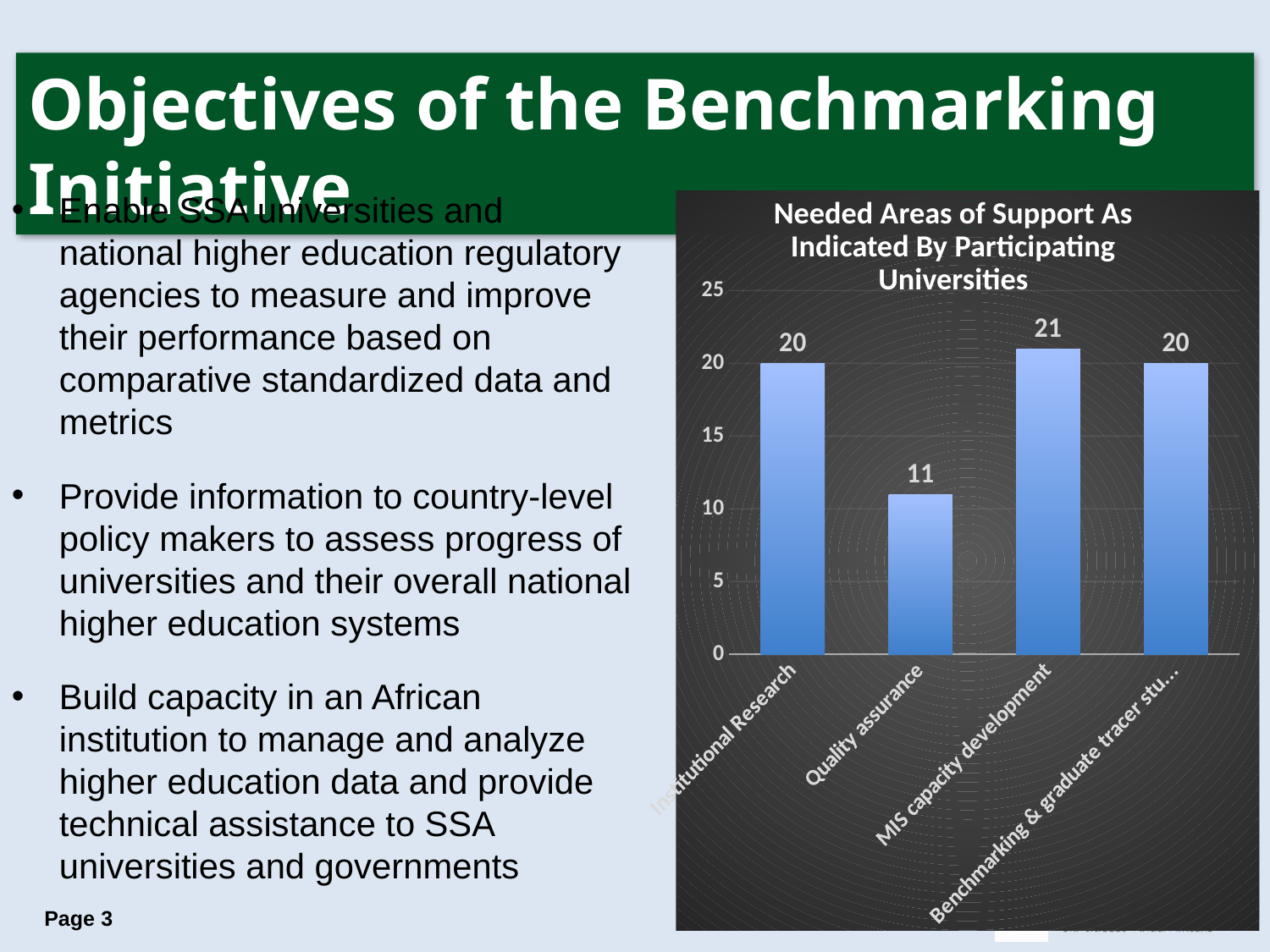
What value is shown for Institutional Research? 20 What kind of chart is shown on the slide? bar chart What is the difference between the values for MIS capacity development and Quality assurance? 10 Which category has the lowest value? Quality assurance How many categories are shown on the x axis? 4 What value is shown for MIS capacity development? 21 Which category has the highest value? MIS capacity development What value is shown for the rightmost bar in the chart? 20 Which is larger, the value for Institutional Research or the value for Quality assurance? Institutional Research What value is shown for Quality assurance? 11 Is the value for Quality assurance greater or less than 15? less What is the title of the chart? Needed Areas of Support As Indicated By Participating Universities